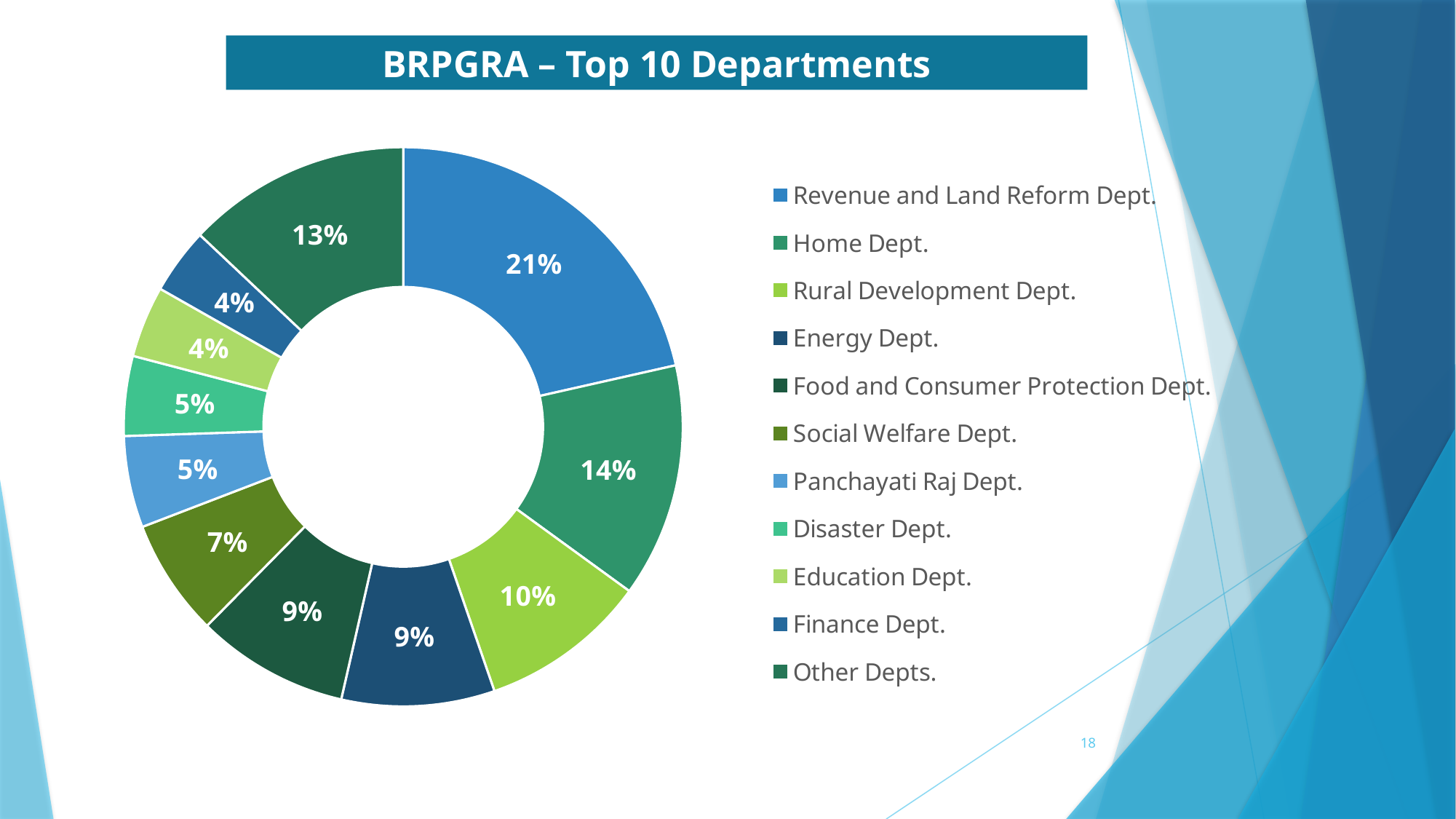
What percentage share does the Revenue and Land Reform Dept. have? 21% Which has a larger share, the Energy Dept. or the Social Welfare Dept.? Energy Dept. What is the difference in percentage points between the Revenue and Land Reform Dept. and the Home Dept.? 7 percentage points What percentage share does the Home Dept. have? 14% What percentage share does the Social Welfare Dept. have? 7% How many entries does the legend list? 11 How many slices does the chart have? 11 What type of chart is shown on the slide? Doughnut (pie) chart What percentage share is shown for Other Depts.? 13% Which department has the largest share of the chart? Revenue and Land Reform Dept. What percentage share does the Rural Development Dept. have? 10% What is the title of the chart? BRPGRA – Top 10 Departments